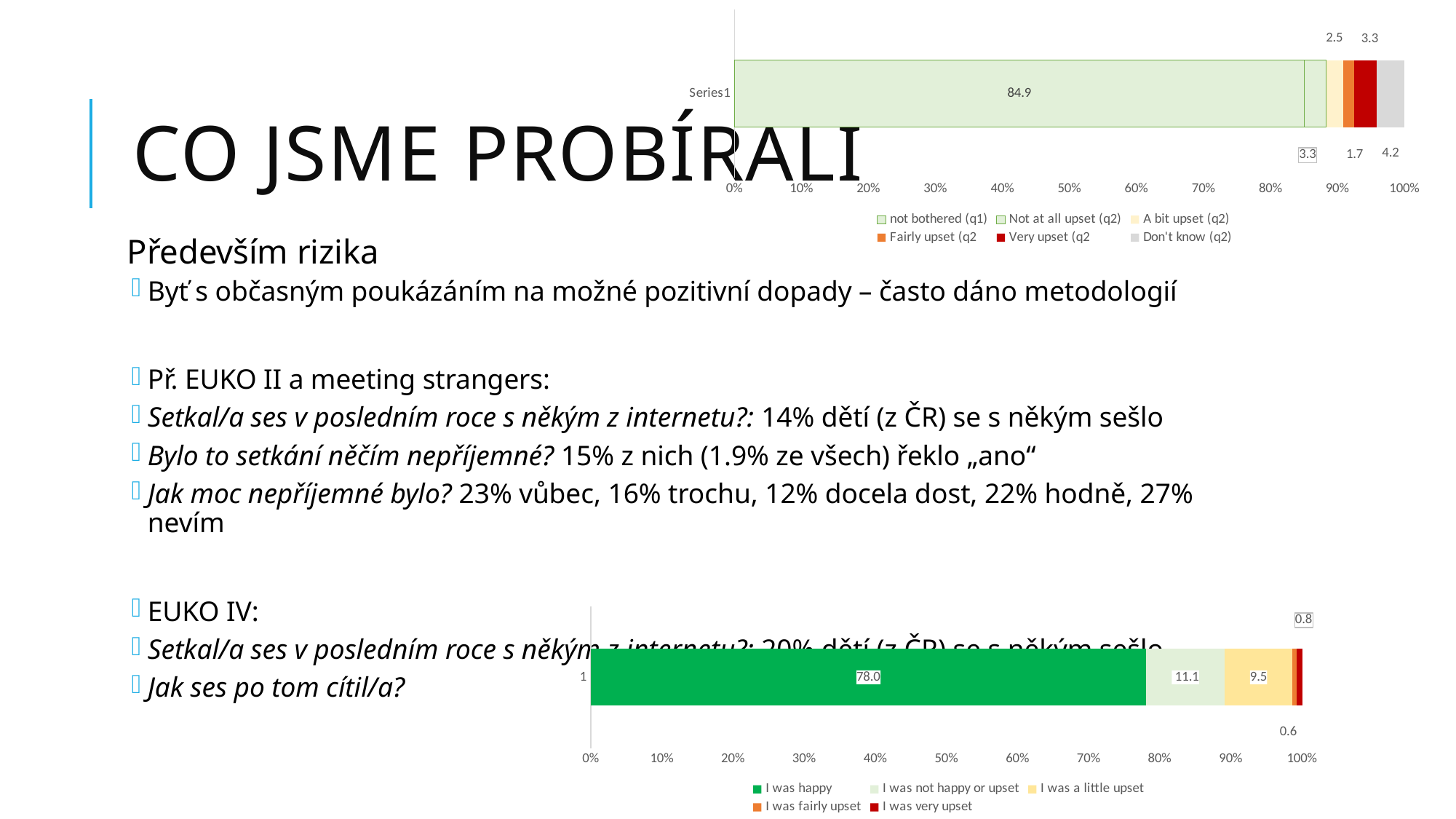
In the bottom chart, what is the value of the 'I was a little upset' segment? 9.5 In the top-right chart, which segment has the highest value? not bothered (q1) What kind of chart is the top-right chart? stacked bar chart How many series does the legend of the top-right chart list? 6 In the top-right chart, what is the value of the largest segment, labelled 'not bothered (q1)'? 84.9 In the bottom chart, what is the value of the 'I was happy' segment? 78.0 In the bottom chart, what is the difference between the 'I was not happy or upset' value and the 'I was a little upset' value? 1.6 In the top-right chart, what is the value shown for the 'Don't know (q2)' segment? 4.2 How many series does the legend of the bottom chart list? 5 In the top-right chart, what is the value shown for the 'Very upset (q2)' segment? 3.3 In the bottom chart, which is larger: the 'I was fairly upset' value or the 'I was very upset' value? I was very upset In the bottom chart, what is the value of the 'I was not happy or upset' segment? 11.1